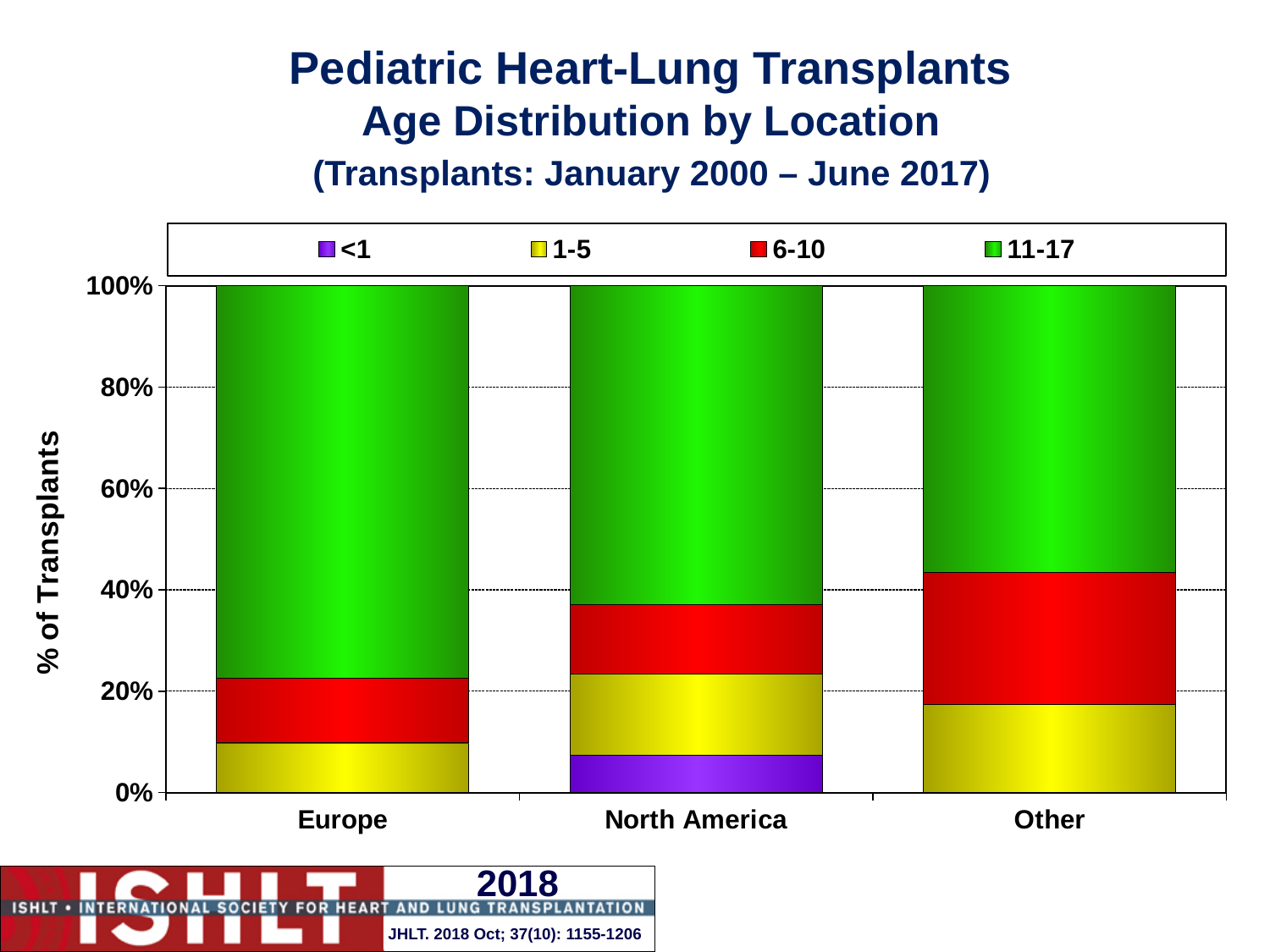
What is the label of the y axis? % of Transplants Which location has the smallest share of transplants in the 11-17 age group? Other What is the total height of the Europe bar? 100% Is the value for the 11-17 age group in Europe greater or less than 60%? greater Is the share of the 1-5 age group larger for Europe or for Other? Other How many locations are shown on the x axis? 3 Which location has the largest share of transplants in the 11-17 age group? Europe What are the age groups listed in the legend? <1, 1-5, 6-10, 11-17 Is the value for the <1 age group in North America greater or less than 20%? less How many age groups does the legend list? 4 Which location has the largest share of transplants in the 6-10 age group? Other What kind of chart is shown on the slide? Stacked bar chart